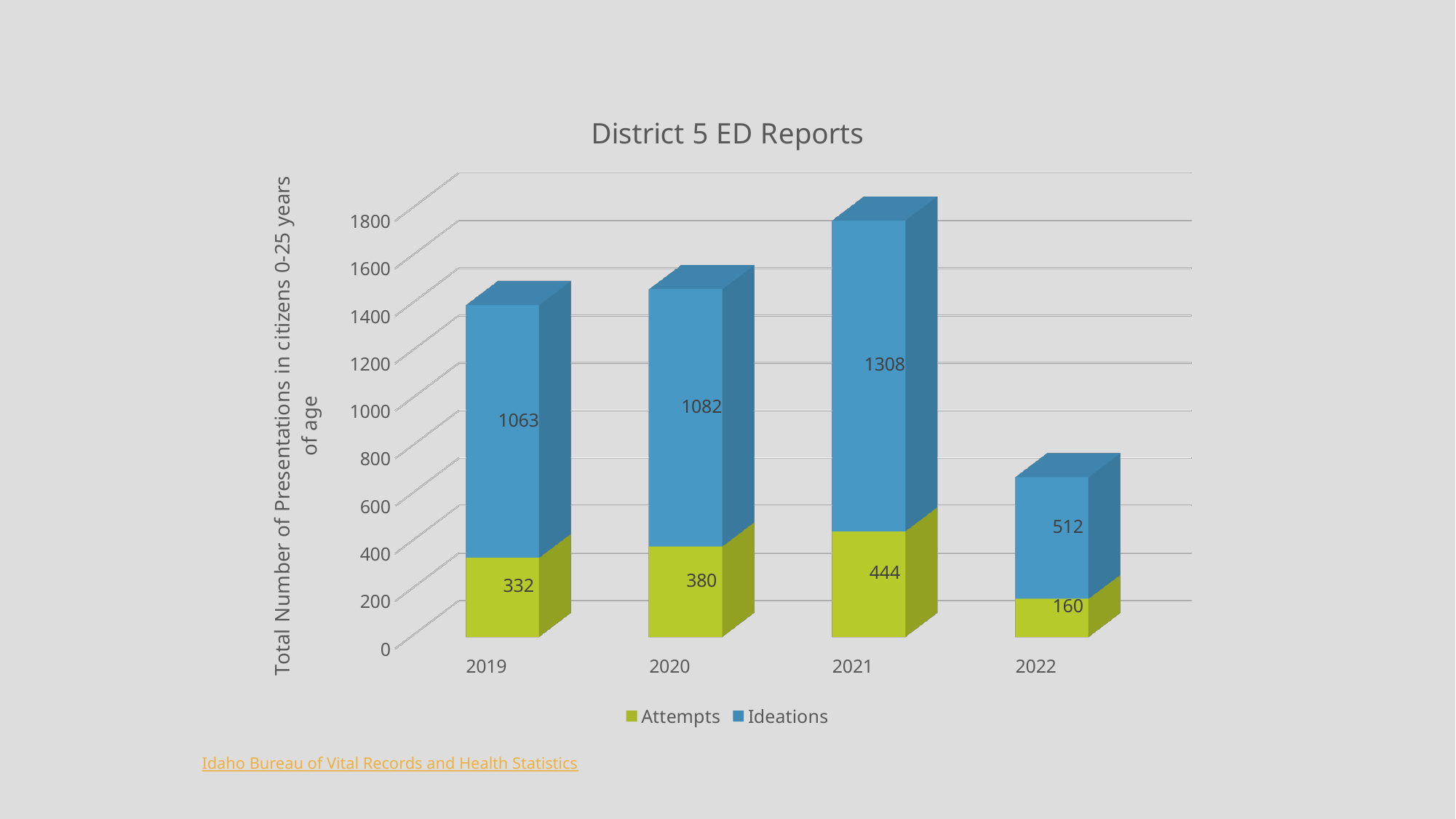
What is the total of the stacked bar for 2022? 672 What is the value for Ideations in 2021? 1308 Which year has the highest value for Ideations? 2021 What is the value for Attempts in 2020? 380 Which is larger: Attempts in 2019 or Attempts in 2021? Attempts in 2021 What kind of chart is shown on the slide? Stacked bar chart How many series does the legend list? 2 What is the total of the stacked bar for 2021? 1752 Which year has the lowest value for Attempts? 2022 What is the difference between Ideations in 2021 and Ideations in 2019? 245 How many years are shown on the x axis? 4 What is the value for Attempts in 2022? 160